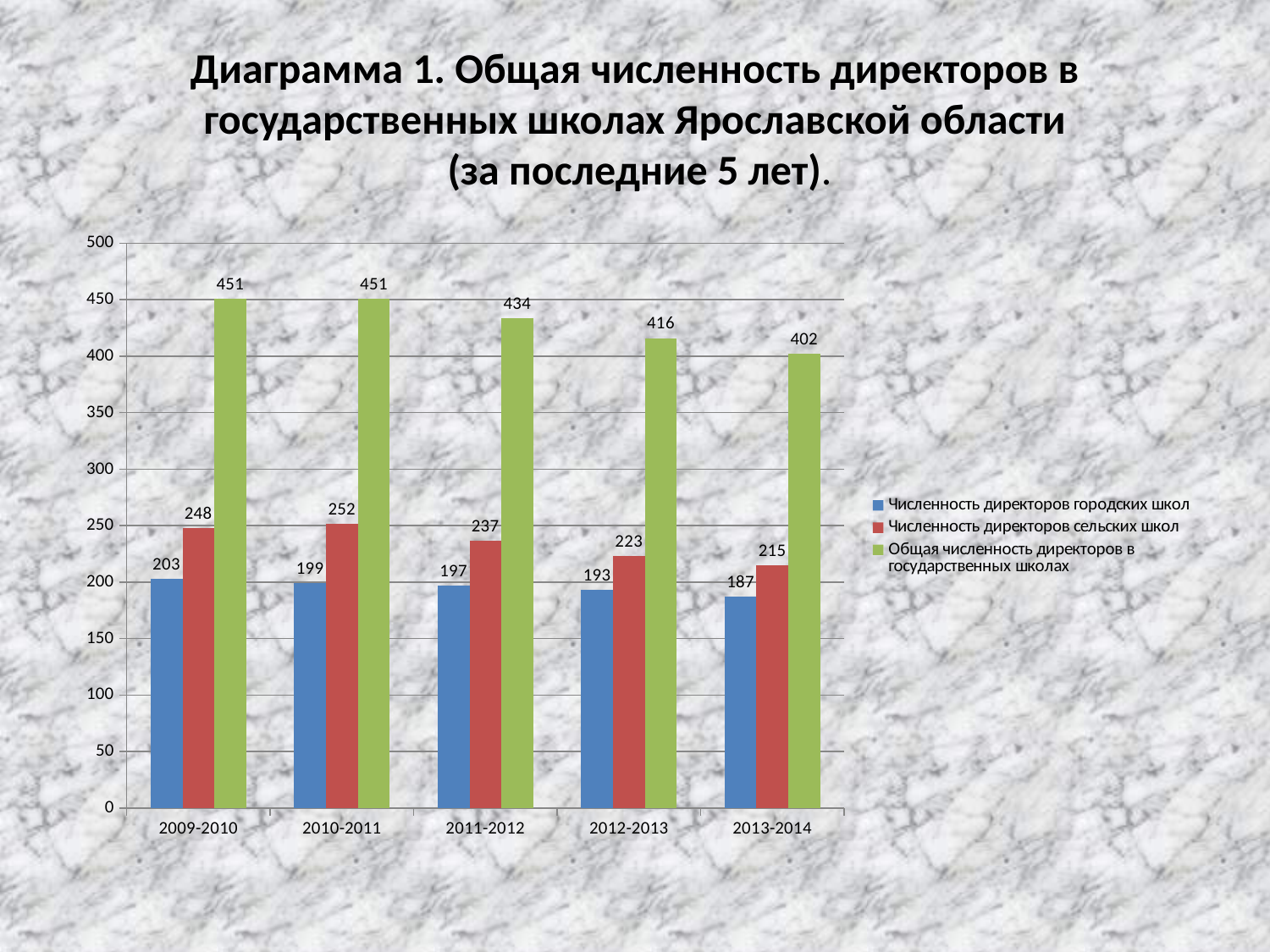
What is the number of directors of rural schools (Численность директоров сельских школ) in 2011-2012? 237 Which is larger in 2012-2013: the number of directors of urban schools or the number of directors of rural schools? Численность директоров сельских школ (223) Does the number of directors of urban schools rise or fall from 2009-2010 to 2013-2014? Fall How many series does the legend list? 3 What is the number of directors of urban schools (Численность директоров городских школ) in 2009-2010? 203 How many school years are shown on the x axis? 5 What kind of chart is shown on the slide? Bar chart What is the total number of directors in state schools (Общая численность директоров в государственных школах) in 2013-2014? 402 In which year is the number of directors of urban schools the lowest? 2013-2014 Is the total number of directors in state schools in 2011-2012 greater or less than 400? greater What is the difference between the total number of directors in 2009-2010 and in 2013-2014? 49 In which year is the number of directors of rural schools the highest? 2010-2011